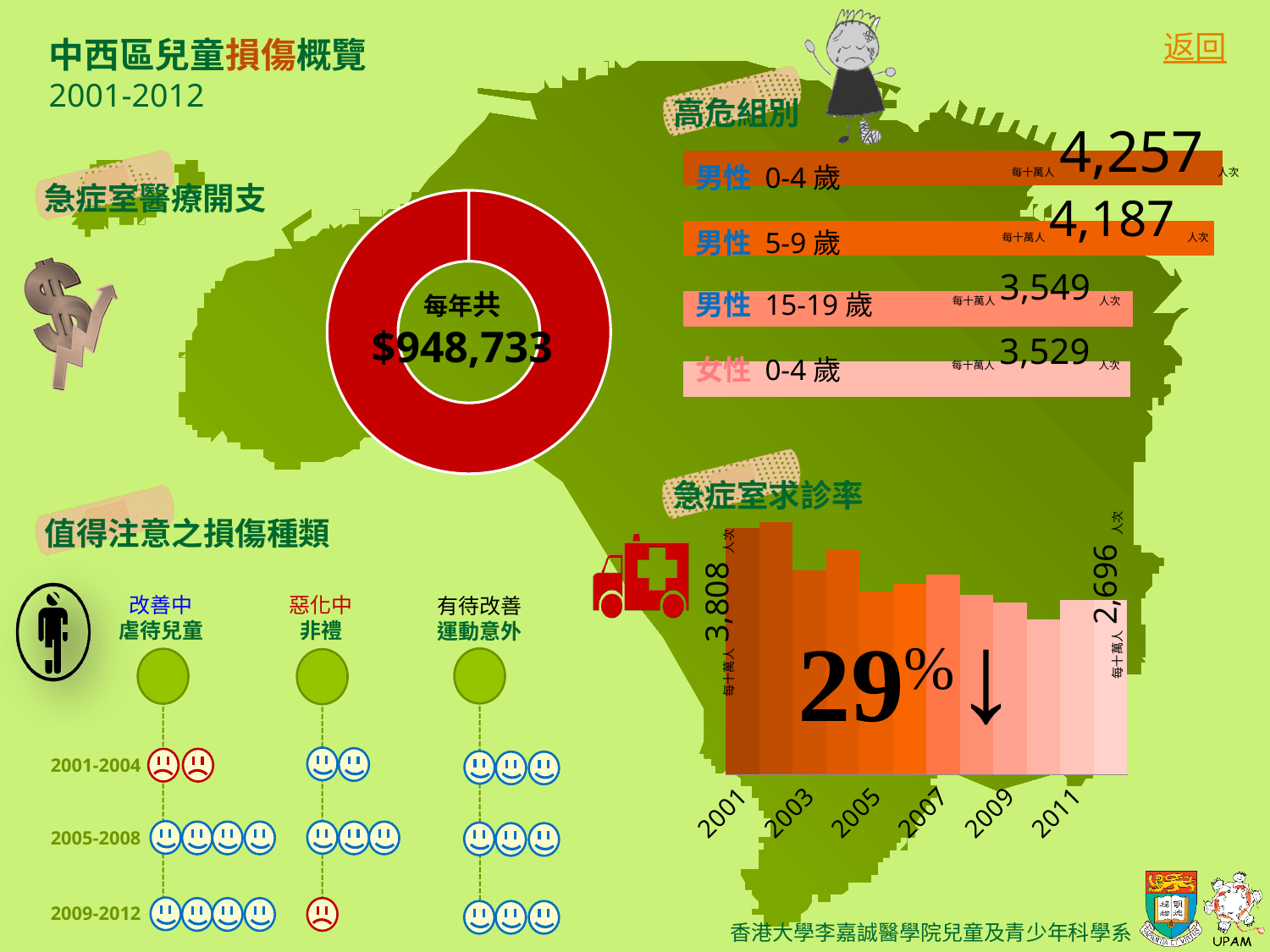
In the 急症室求診率 chart, what is the value for 2001? 3,808 In the 高危組別 chart, which group has the lowest value? 女性 0-4 歲 In the 高危組別 chart, which group has the highest value? 男性 0-4 歲 In the 高危組別 chart, what is the difference between the values for 男性 0-4 歲 and 男性 5-9 歲? 70 In the 急症室求診率 chart, what is the difference between the first value (3,808) and the last value (2,696)? 1,112 In the 高危組別 chart, how many groups are shown? 4 In the 急症室求診率 chart, do the values rise or fall from 2001 to the last year? fall In the 高危組別 chart, what is the value for 男性 0-4 歲? 4,257 In the 急症室求診率 chart, what is the value labelled on the last bar? 2,696 In the 高危組別 chart, what is the value for 女性 0-4 歲? 3,529 What total annual amount is shown in the centre of the 急症室醫療開支 donut chart? $948,733 In the 高危組別 chart, which is larger: the value for 男性 5-9 歲 or 男性 15-19 歲? 男性 5-9 歲